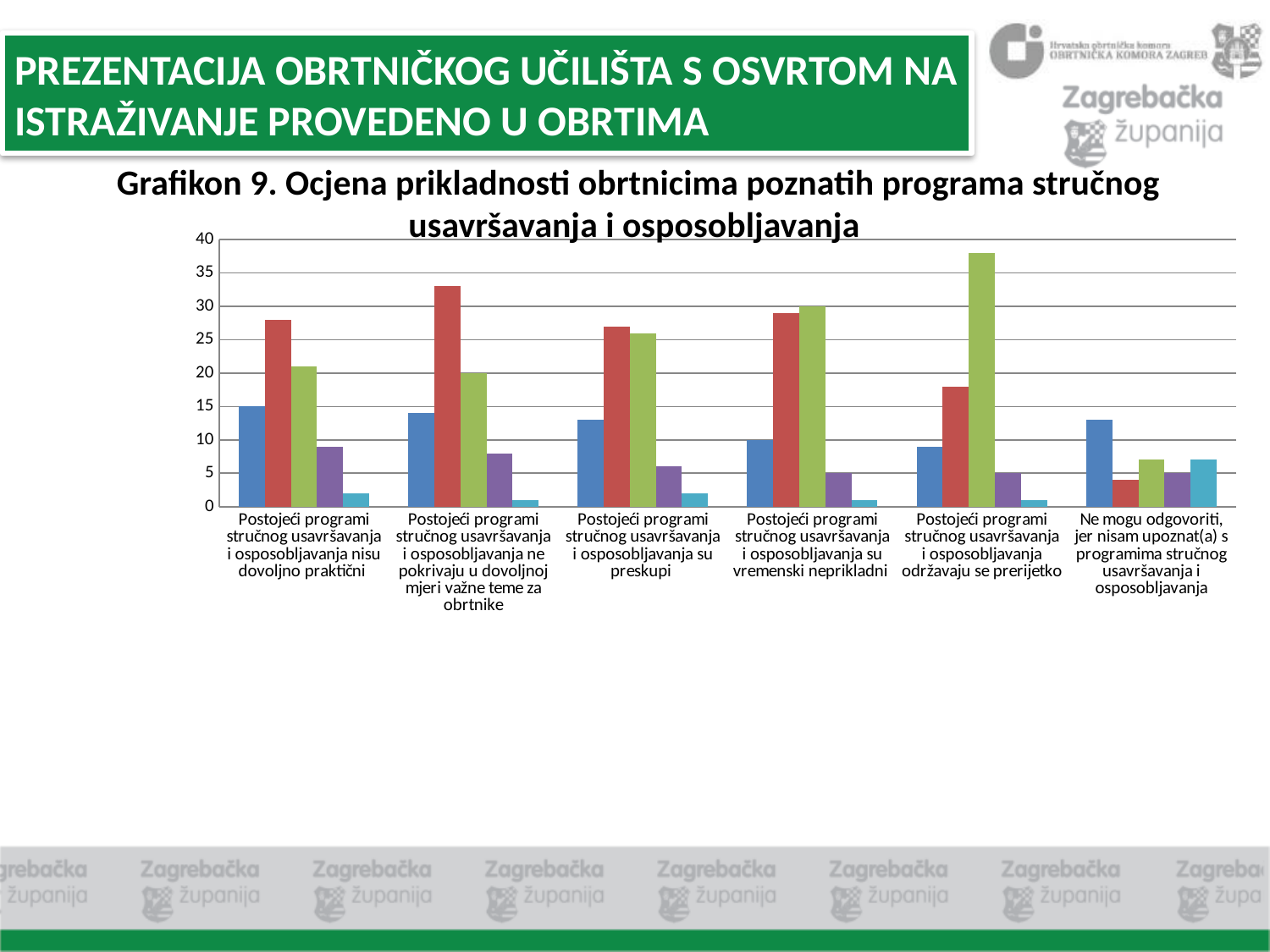
How many categories are shown along the x axis of the chart? 6 Is the purple bar for 'Postojeći programi stručnog usavršavanja i osposobljavanja su preskupi' greater or less than 10? less Which category contains the tallest bar in the chart? Postojeći programi stručnog usavršavanja i osposobljavanja održavaju se prerijetko Is the red bar for 'Postojeći programi stručnog usavršavanja i osposobljavanja su vremenski neprikladni' greater or less than 25? greater How many bars are plotted for each category in the chart? 5 What is the title of the chart? Grafikon 9. Ocjena prikladnosti obrtnicima poznatih programa stručnog usavršavanja i osposobljavanja Among the red bars, which category has the lowest value? Ne mogu odgovoriti, jer nisam upoznat(a) s programima stručnog usavršavanja i osposobljavanja Is the green bar for 'Postojeći programi stručnog usavršavanja i osposobljavanja održavaju se prerijetko' greater or less than 35? greater What kind of chart is shown on the slide? bar chart In the category 'Ne mogu odgovoriti, jer nisam upoznat(a) s programima stručnog usavršavanja i osposobljavanja', which is larger, the blue bar or the red bar? the blue bar